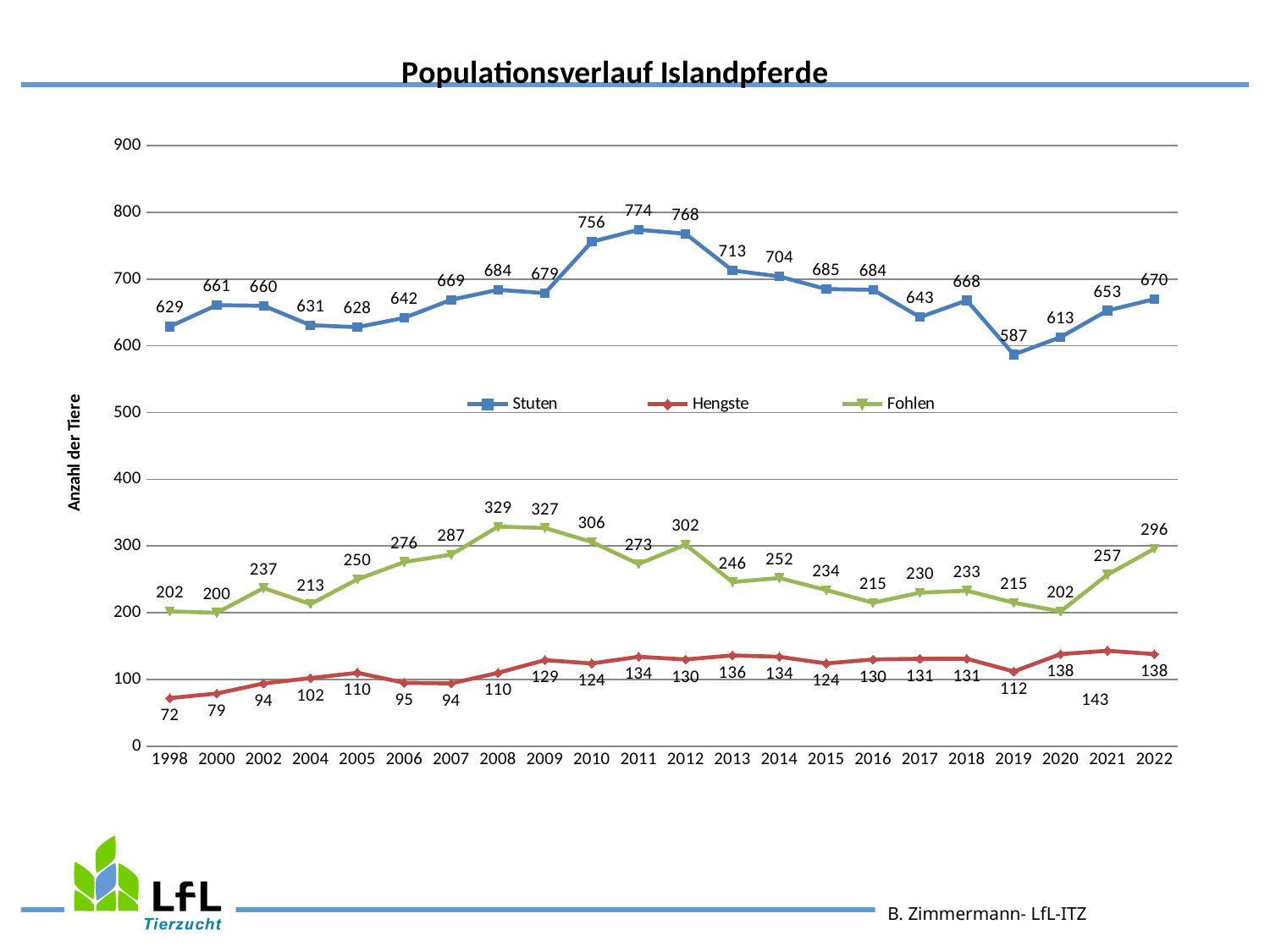
What is the difference between the Stuten values for 2022 and 2019? 83 In which year is the Hengste series at its highest? 2021 What kind of chart is shown on the slide? line chart In which year is the Stuten series at its highest? 2011 What is the value for Stuten in 2011? 774 Which year has the larger Fohlen value, 2011 or 2012? 2012 In which year is the Stuten series at its lowest? 2019 Does the Fohlen series rise or fall from 2008 to 2011? fall How many years are shown on the x axis? 22 What is the value for Fohlen in 2008? 329 What is the value for Hengste in 1998? 72 How many series does the legend list? 3